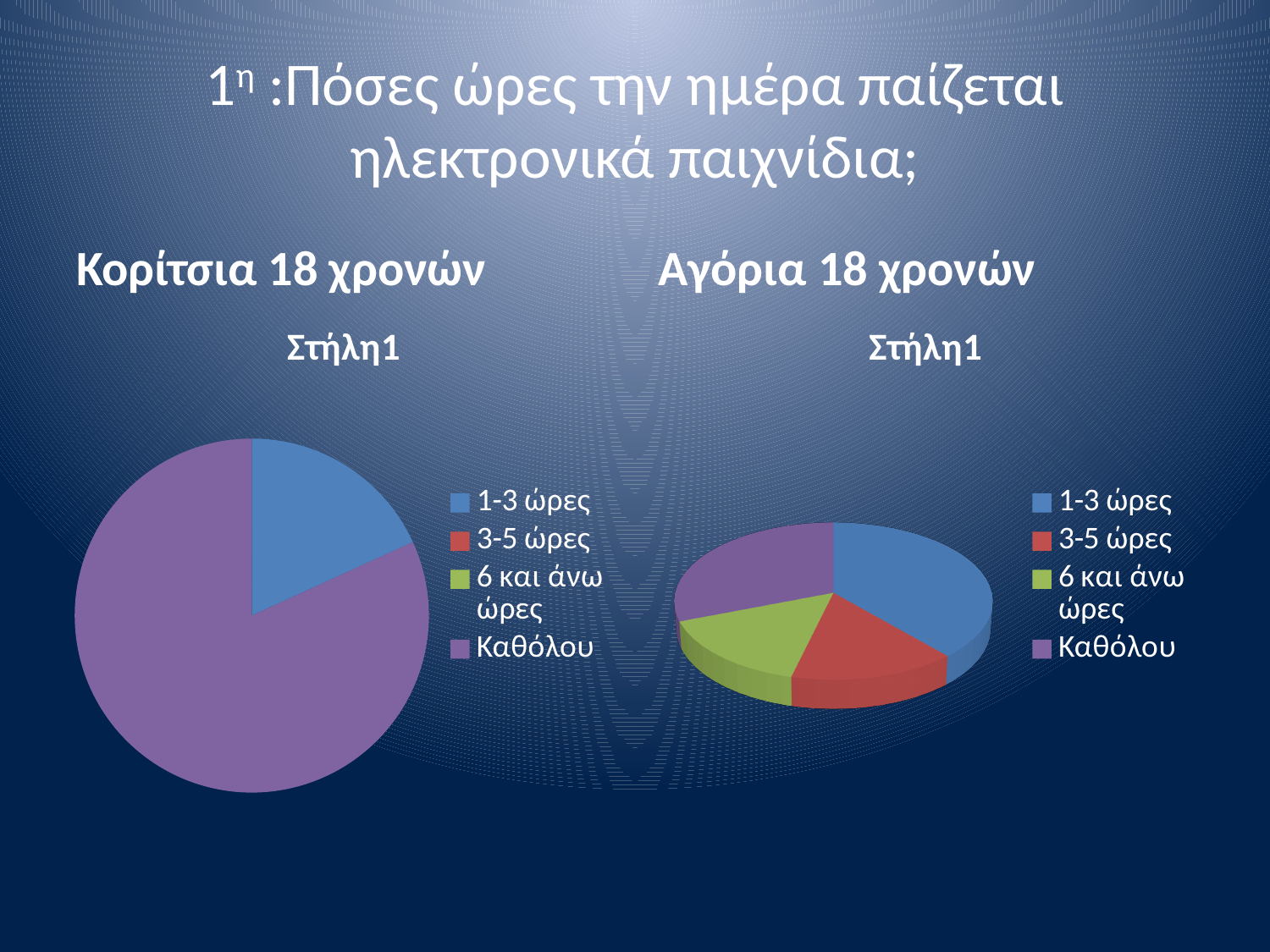
How many slices are visible in the 'Κορίτσια 18 χρονών' pie chart? 2 How many slices are visible in the 'Αγόρια 18 χρονών' pie chart? 4 What kind of chart is used for the 'Κορίτσια 18 χρονών' chart? pie chart Which colour represents 'Καθόλου' in the legends of both charts? purple In the 'Κορίτσια 18 χρονών' chart, which of the visible slices is the smallest? 1-3 ώρες In the 'Αγόρια 18 χρονών' chart, which slice is larger: '1-3 ώρες' or '3-5 ώρες'? 1-3 ώρες How many entries does the legend of the 'Αγόρια 18 χρονών' chart list? 4 What kind of chart is used for the 'Αγόρια 18 χρονών' chart? pie chart In the 'Κορίτσια 18 χρονών' chart, which slice is larger: '1-3 ώρες' or 'Καθόλου'? Καθόλου In the 'Κορίτσια 18 χρονών' chart, which category has the largest slice? Καθόλου What is the series name shown above each pie chart? Στήλη1